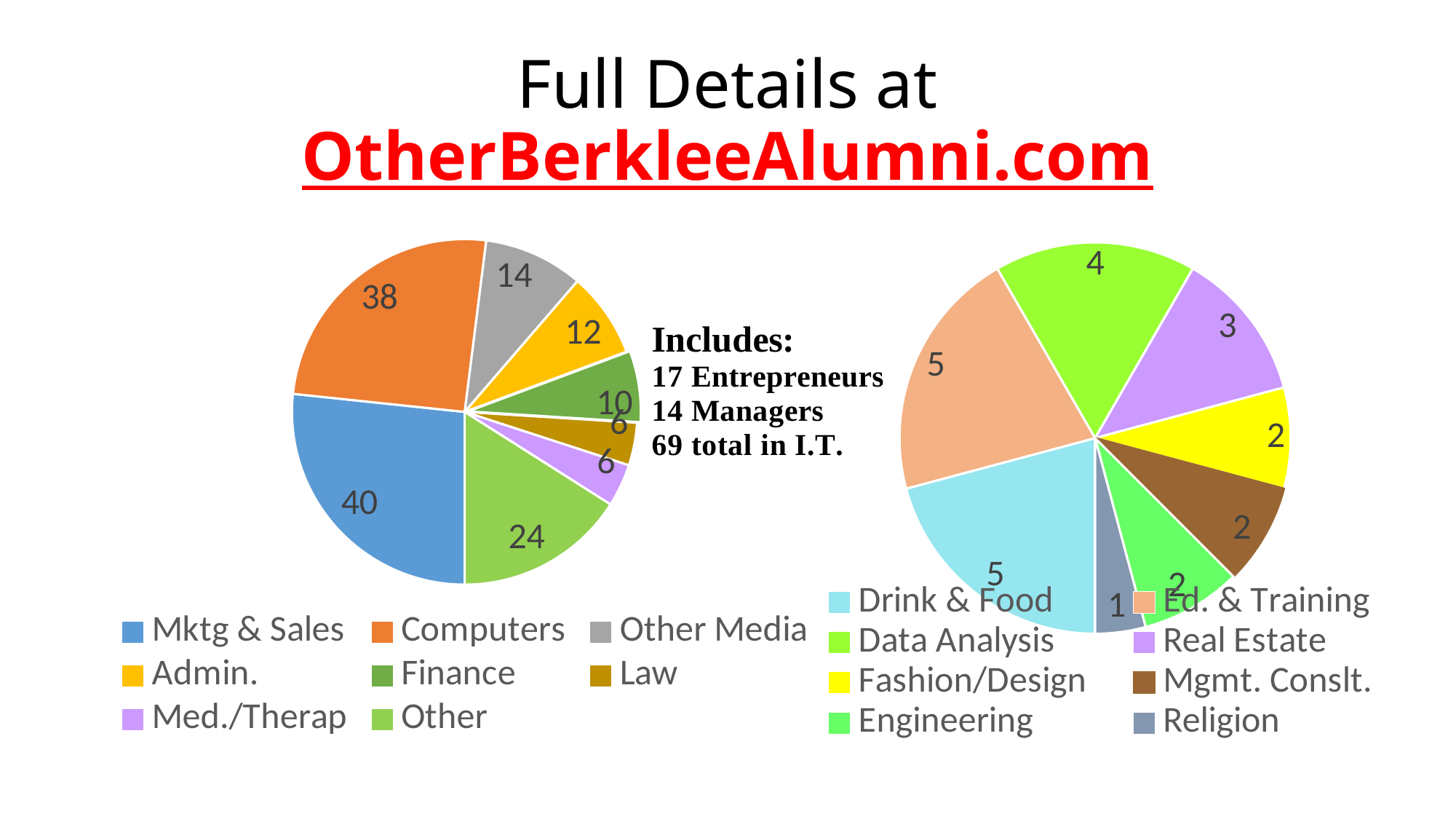
On the left pie chart, which is larger, Admin. or Finance? Admin. On the left pie chart, what colour is the Computers slice? Orange How many categories does the left pie chart's legend list? 8 On the right pie chart, what is the value for Data Analysis? 4 What type of chart is shown on the right side of the slide? Pie chart On the right pie chart, what is the difference between Ed. & Training and Fashion/Design? 3 On the left pie chart, what is the difference between the Other slice and the Other Media slice? 10 On the left pie chart, which category has the largest slice? Mktg & Sales On the left pie chart, what is the value for Computers? 38 On the right pie chart, which category has the smallest slice? Religion On the left pie chart, what is the value for Mktg & Sales? 40 On the right pie chart, what is the value for Real Estate? 3